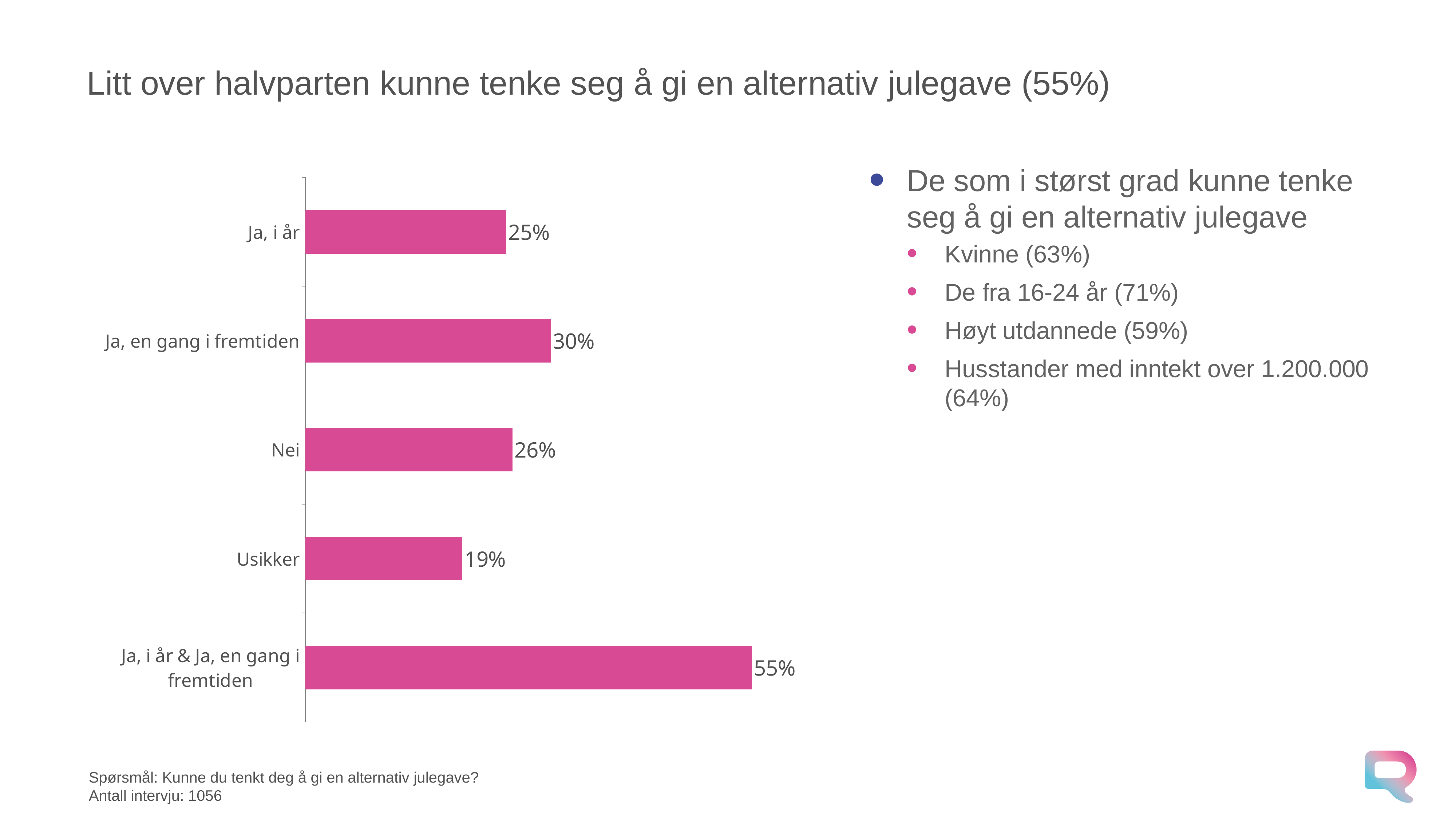
What is the value for "Ja, i år & Ja, en gang i fremtiden"? 55% What is the value for "Nei"? 26% What is the value for "Usikker"? 19% What is the value for "Ja, en gang i fremtiden"? 30% How many categories are shown in the chart? 5 Which is larger, "Ja, en gang i fremtiden" or "Nei"? Ja, en gang i fremtiden What is the value for "Ja, i år"? 25% What is the difference between "Ja, en gang i fremtiden" and "Ja, i år"? 5% What kind of chart is shown on the slide? Bar chart What is the difference between "Nei" and "Usikker"? 7% Which category has the lowest value? Usikker Which category has the highest value? Ja, i år & Ja, en gang i fremtiden